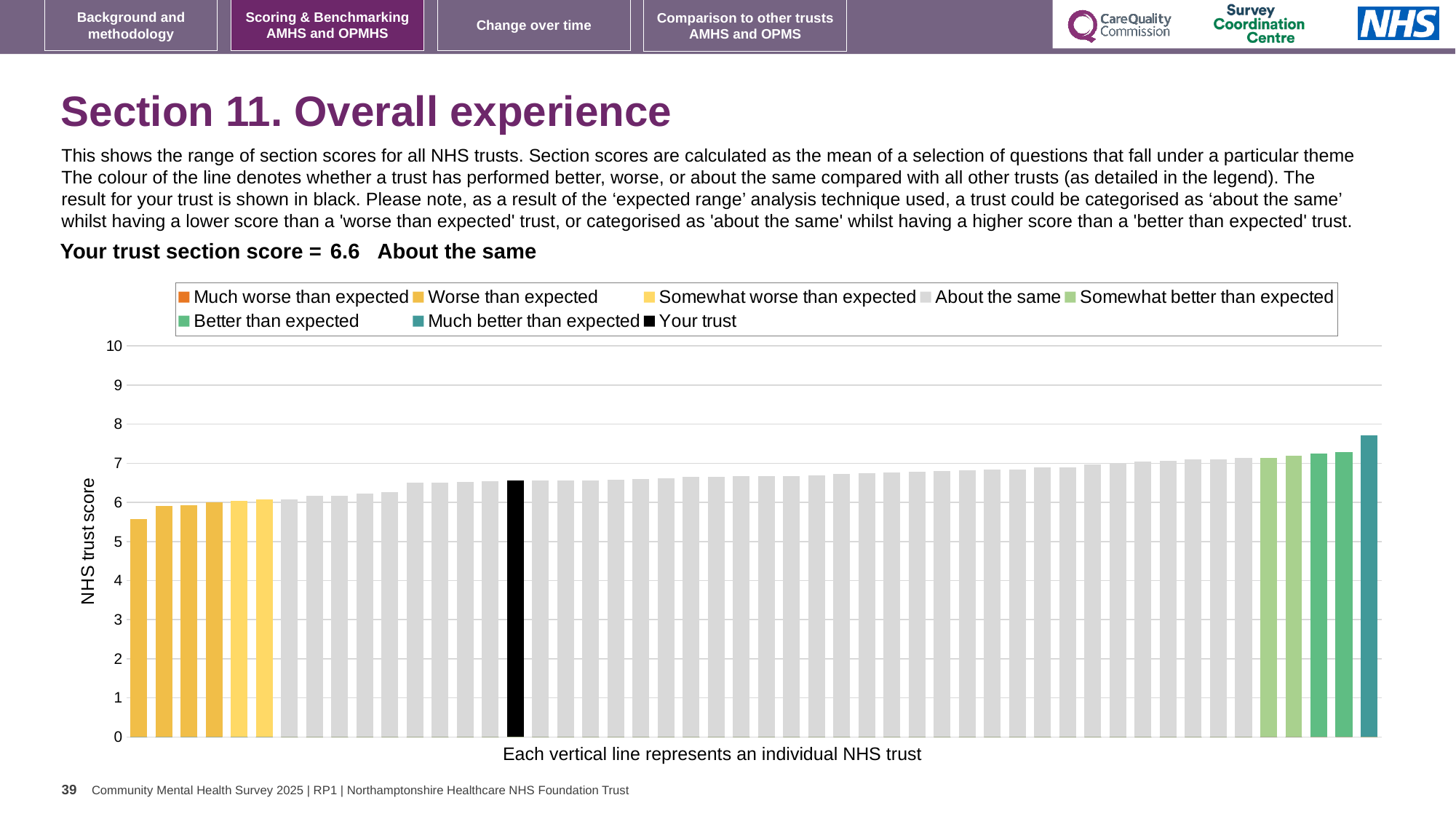
How many bars are coloured as 'Much better than expected' (teal)? 1 Is the value of the black 'Your trust' bar greater or less than 6? greater What kind of chart is shown on the slide? bar chart What colour is the bar representing your trust? black Is the value of the highest bar on the chart greater or less than 8? less Do the bar values rise or fall from left to right along the x axis? rise Is the value of the lowest bar on the chart greater or less than 6? less How many entries does the chart legend list? 8 Which category is your trust placed in for this section? About the same What is the label on the vertical axis of the chart? NHS trust score What is the section score for your trust shown on the slide? 6.6